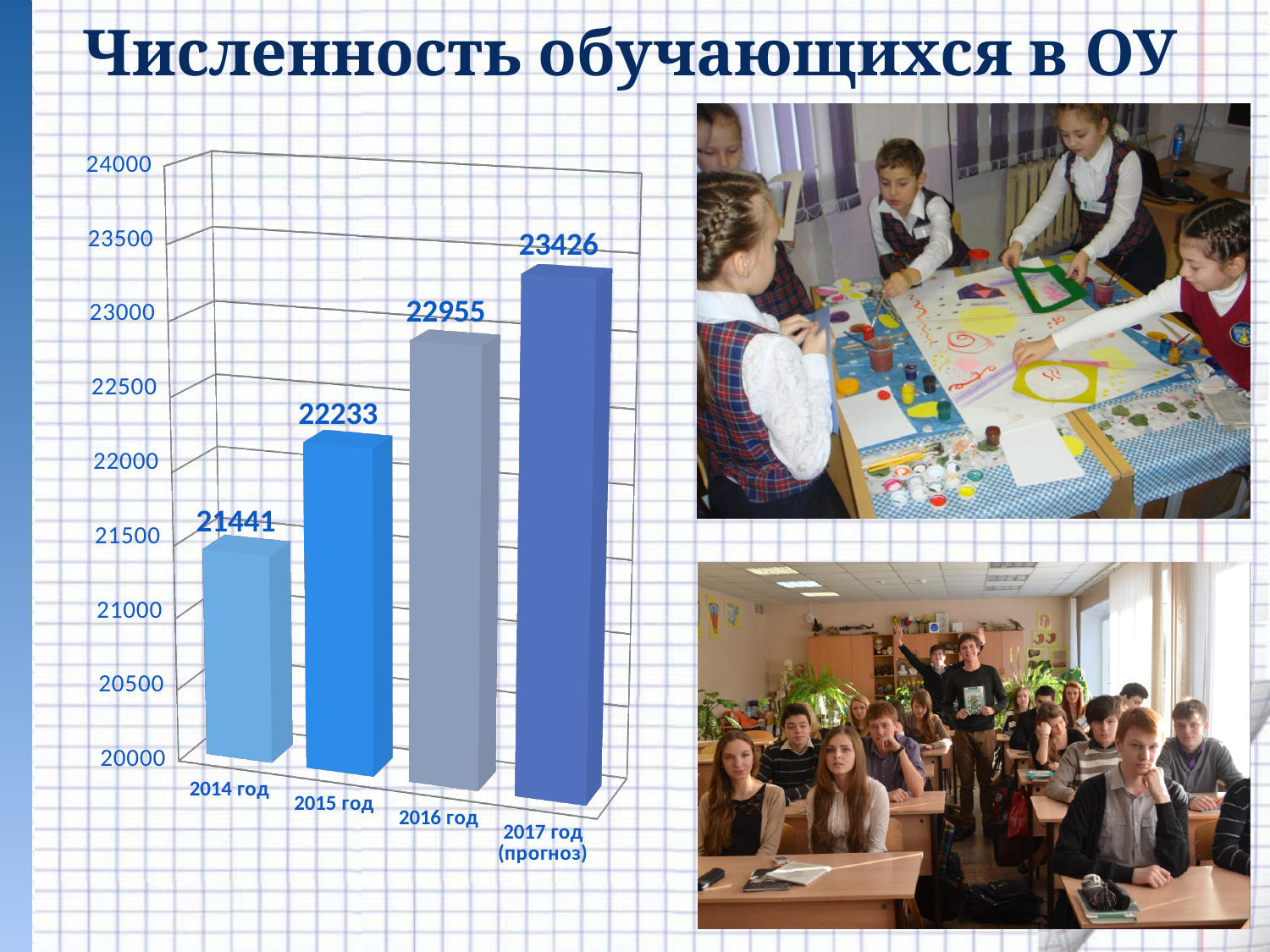
Is the value for 2016 год greater or less than 23000? less Which year has the lowest value? 2014 год Which is larger, the value for 2015 год or the value for 2016 год? 2016 год What kind of chart is shown on the slide? bar chart What is the difference between the values for 2015 год and 2014 год? 792 What is the value for 2017 год (прогноз)? 23426 Which year has the highest value? 2017 год (прогноз) What is the value for 2014 год? 21441 What is the difference between the values for 2017 год (прогноз) and 2016 год? 471 Do the values rise or fall from 2014 год to 2017 год (прогноз)? rise What is the value for 2016 год? 22955 How many categories are shown on the chart? 4